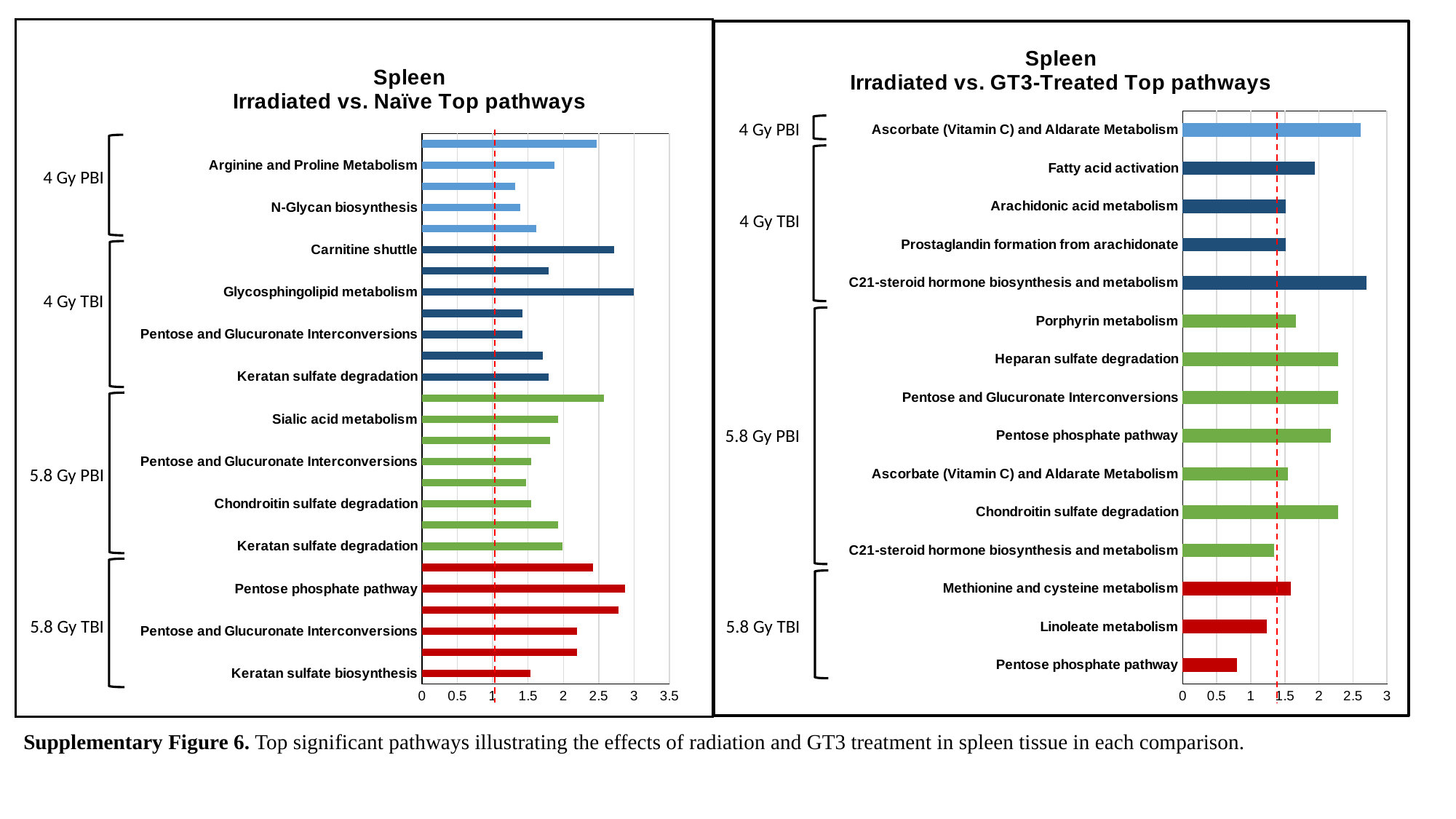
In the left chart (Irradiated vs. Naïve), is the value for Glycosphingolipid metabolism greater or less than 2.5? greater In the right chart (Irradiated vs. GT3-Treated), which has the larger value: Fatty acid activation or Arachidonic acid metabolism? Fatty acid activation In the right chart (Irradiated vs. GT3-Treated), is the value for Pentose phosphate pathway under 5.8 Gy TBI greater or less than 1? less In the right chart (Irradiated vs. GT3-Treated), is the value for Fatty acid activation greater or less than 1.5? greater In the 'Spleen Irradiated vs. GT3-Treated Top pathways' chart on the right, which pathway has the lowest value? Pentose phosphate pathway (5.8 Gy TBI) In the left chart (Irradiated vs. Naïve), which has the larger value: Carnitine shuttle or N-Glycan biosynthesis? Carnitine shuttle What kind of chart is the 'Spleen Irradiated vs. Naïve Top pathways' chart on the left? bar chart How many pathways are listed in the 'Spleen Irradiated vs. GT3-Treated Top pathways' chart on the right? 15 In the right chart (Irradiated vs. GT3-Treated), which has the larger value: Heparan sulfate degradation or Porphyrin metabolism? Heparan sulfate degradation What is the title of the chart on the right side of the slide? Spleen Irradiated vs. GT3-Treated Top pathways